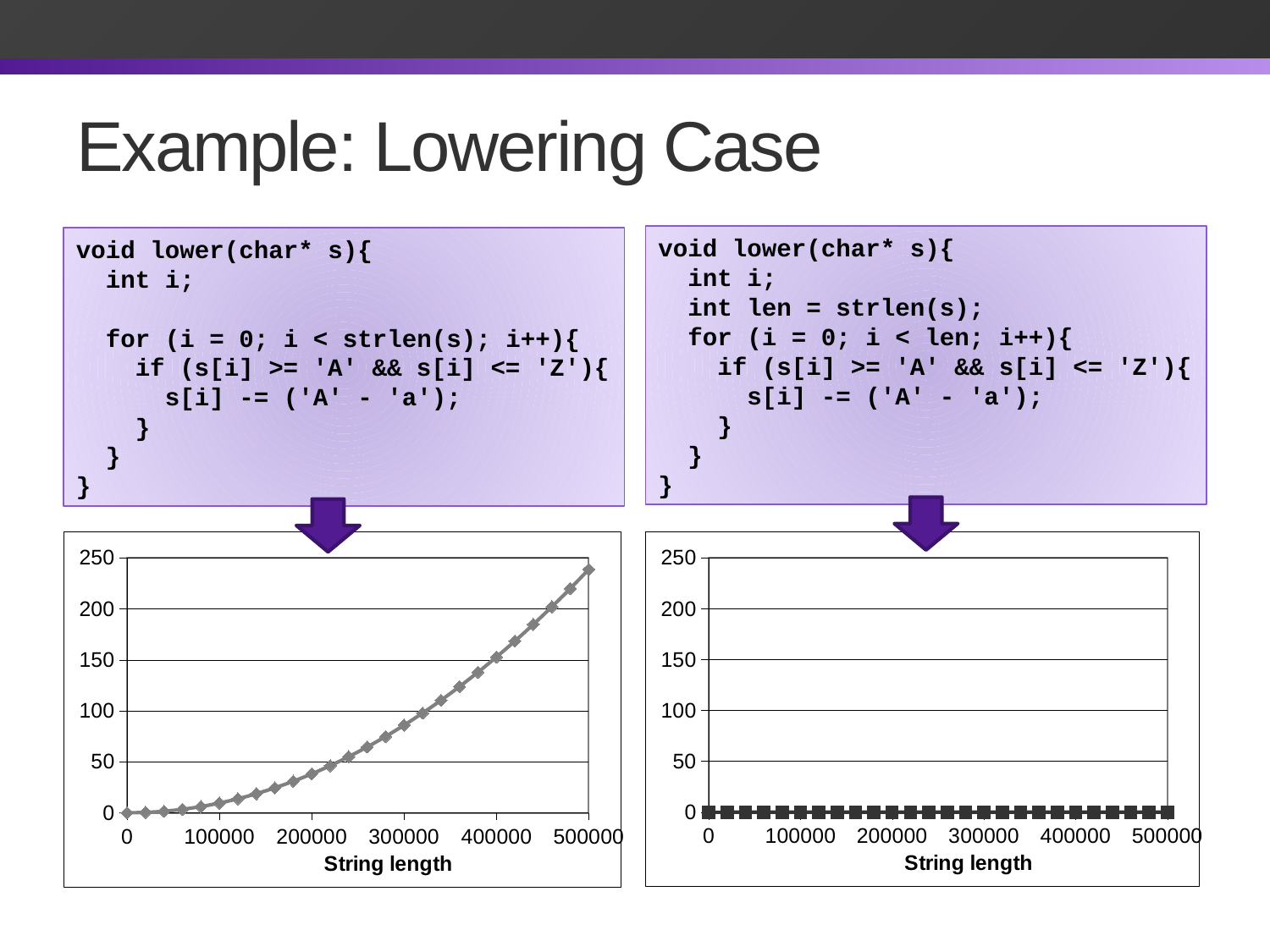
What kind of chart is the chart on the left side of the slide? line chart In the chart on the left side of the slide, is the value at a string length of 300000 greater or less than 100? less In the chart on the left side of the slide, which string length has the higher value: 100000 or 500000? 500000 What is the x-axis title of the chart on the left side of the slide? String length In the chart on the right side of the slide, do the values rise, fall, or stay flat as string length increases? stay flat In the chart on the left side of the slide, do the values rise or fall as string length increases? rise In the chart on the left side of the slide, is the value at a string length of 500000 greater or less than 200? greater In the chart on the left side of the slide, is the value at a string length of 200000 greater or less than 50? less What is the highest tick value shown on the y-axis of the chart on the right side of the slide? 250 At a string length of 500000, which chart shows the larger value: the chart on the left or the chart on the right? the chart on the left